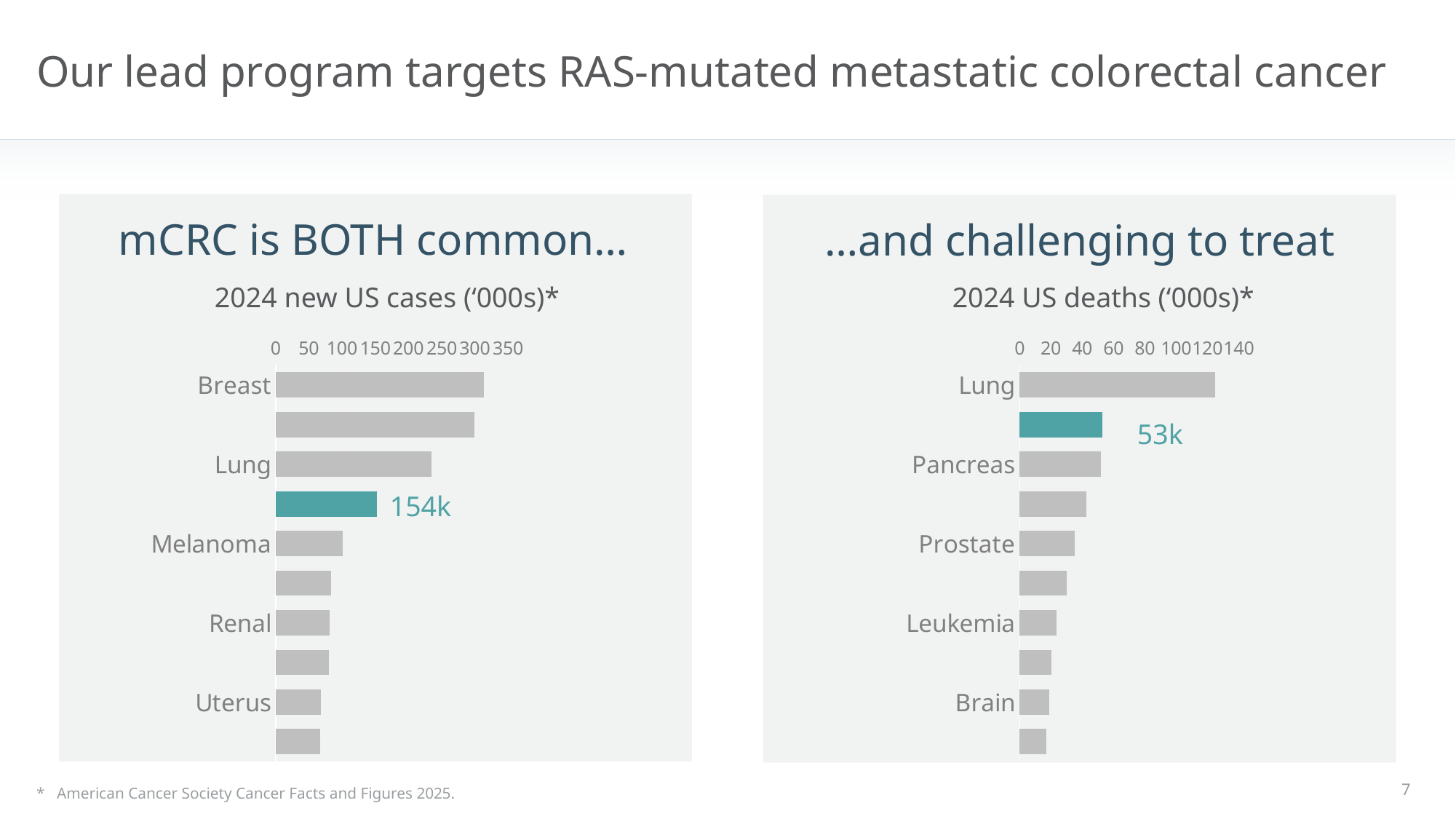
How many bars are plotted on the '2024 US deaths' chart? 10 On the '2024 US deaths' chart, what value is printed next to the highlighted teal bar? 53k On the '2024 new US cases' chart, what value is printed next to the highlighted teal bar? 154k On the '2024 US deaths' chart, is the value for Lung greater or less than 100? greater On the '2024 new US cases' chart, is the value for Breast greater or less than 250? greater On the '2024 US deaths' chart, is the value for Brain greater or less than 40? less On the '2024 US deaths' chart, which category has the highest value? Lung What kind of chart is the '2024 new US cases' chart? Bar chart On the '2024 new US cases' chart, which labeled category has the highest value? Breast On the '2024 new US cases' chart, which is larger, Breast or Lung? Breast On the '2024 US deaths' chart, which is larger, Lung or Pancreas? Lung